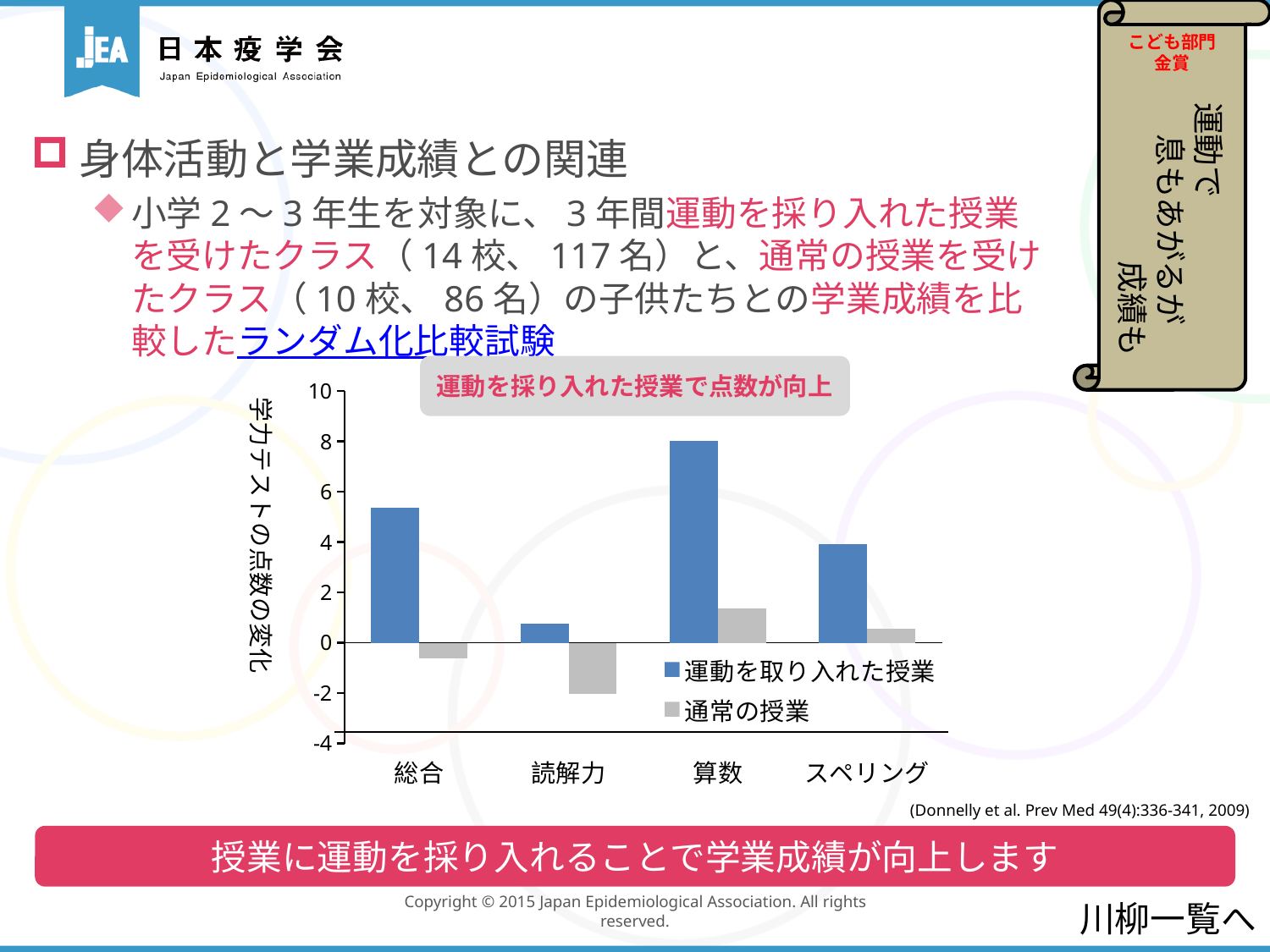
For 総合, which series has the larger value: 運動を取り入れた授業 or 通常の授業? 運動を取り入れた授業 What kind of chart is shown on the slide? bar chart Is the value for スペリング in the 運動を取り入れた授業 series greater or less than 2? greater Is the value for 算数 in the 通常の授業 series greater or less than 2? less How many series does the legend list? 2 Which category has the lowest value for 通常の授業? 読解力 Is the value for 総合 in the 運動を取り入れた授業 series greater or less than 4? greater How many categories are shown on the x axis? 4 In the 運動を取り入れた授業 series, which is larger: 算数 or スペリング? 算数 Which category has the highest value for 運動を取り入れた授業? 算数 What is the title of the vertical axis? 学力テストの点数の変化